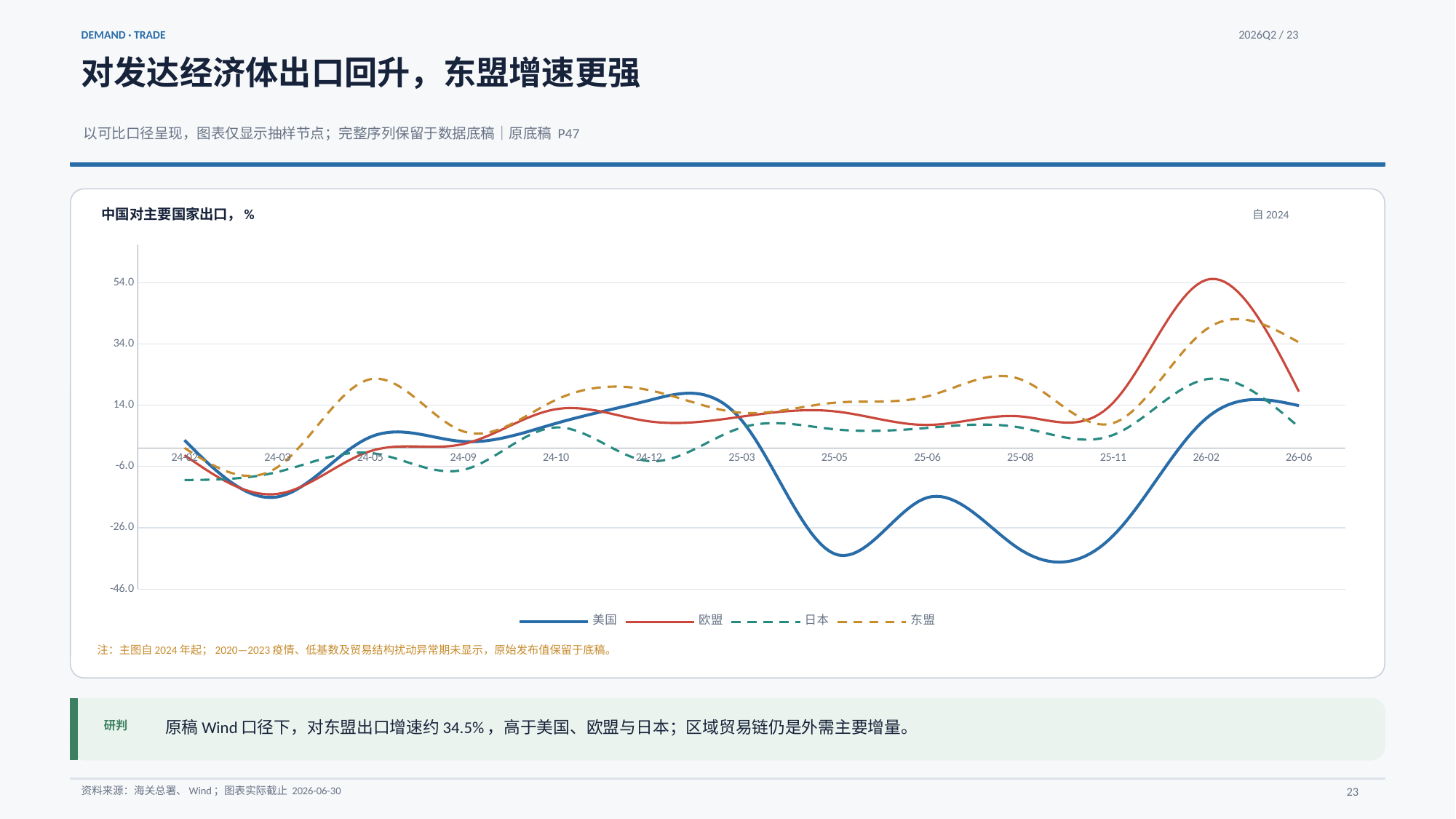
Is the value for 欧盟 at 26-02 greater or less than 34.0? greater What is the title of the chart? 中国对主要国家出口，% At 26-02, which is higher, 欧盟 or 美国? 欧盟 Which series reaches the highest peak on the chart? 欧盟 Is the value for 美国 at 25-05 greater or less than -26.0? less How many series does the legend list? 4 Is the value for 东盟 at 24-05 greater or less than 14.0? greater Which series is drawn as an orange dashed line? 东盟 Which series reaches the lowest point on the chart? 美国 Does the 美国 line rise or fall between 25-03 and 25-05? fall What kind of chart is shown on the slide? line chart At 25-05, which is higher, 东盟 or 美国? 东盟